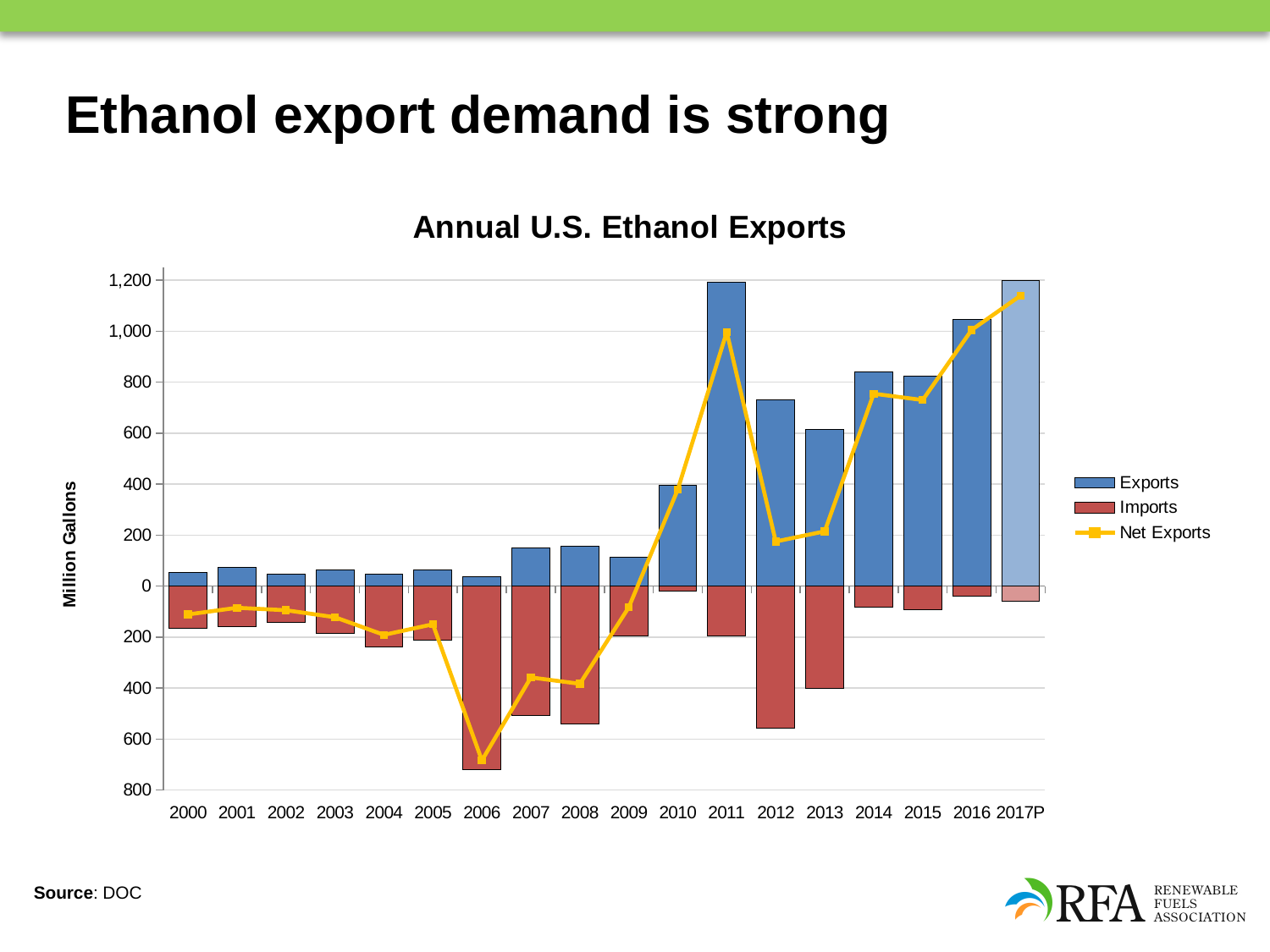
What is the label on the vertical axis? Million Gallons What is the title of the chart? Annual U.S. Ethanol Exports Is the value for Net Exports in 2016 greater or less than 800? greater In which year are Net Exports lowest? 2006 Is the value for Exports in 2011 greater or less than 1,000? greater Do Exports rise or fall from 2013 to 2017P? rise Is the value for Exports in 2013 greater or less than 800? less How many years are shown on the x axis? 18 What kind of chart is this? Bar chart with a line In which year are Imports largest in magnitude? 2006 How many series does the legend list? 3 Which year has higher Exports, 2015 or 2016? 2016